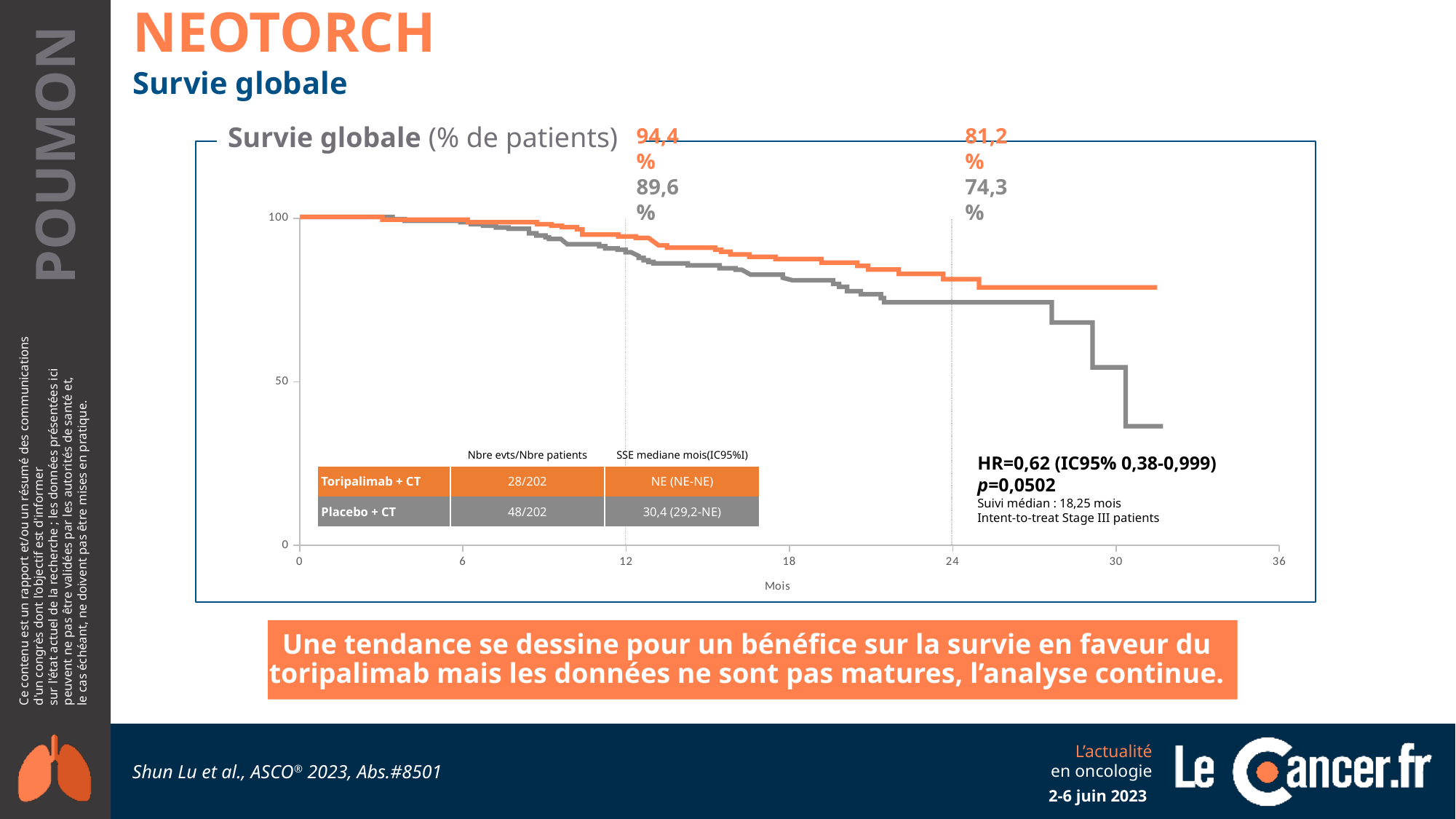
Which arm has the higher overall survival at 24 months, Toripalimab + CT or Placebo + CT? Toripalimab + CT What is the overall survival rate for Placebo + CT at 12 months? 89,6 % What is the overall survival rate for Placebo + CT at 24 months? 74,3 % How many treatment arms are plotted on the chart? 2 What is the overall survival rate for Toripalimab + CT at 12 months? 94,4 % What is the difference in overall survival between Toripalimab + CT and Placebo + CT at 24 months? 6,9 % What is the overall survival rate for Toripalimab + CT at 24 months? 81,2 % What kind of chart is shown on the slide? Line chart (Kaplan-Meier survival curve) Is the Placebo + CT survival curve greater or less than 50 at 31 months? less What is the difference in overall survival between the two arms at 12 months? 4,8 % Do the survival curves rise or fall as months increase along the x axis? fall Is the Toripalimab + CT survival curve greater or less than 50 at 30 months? greater